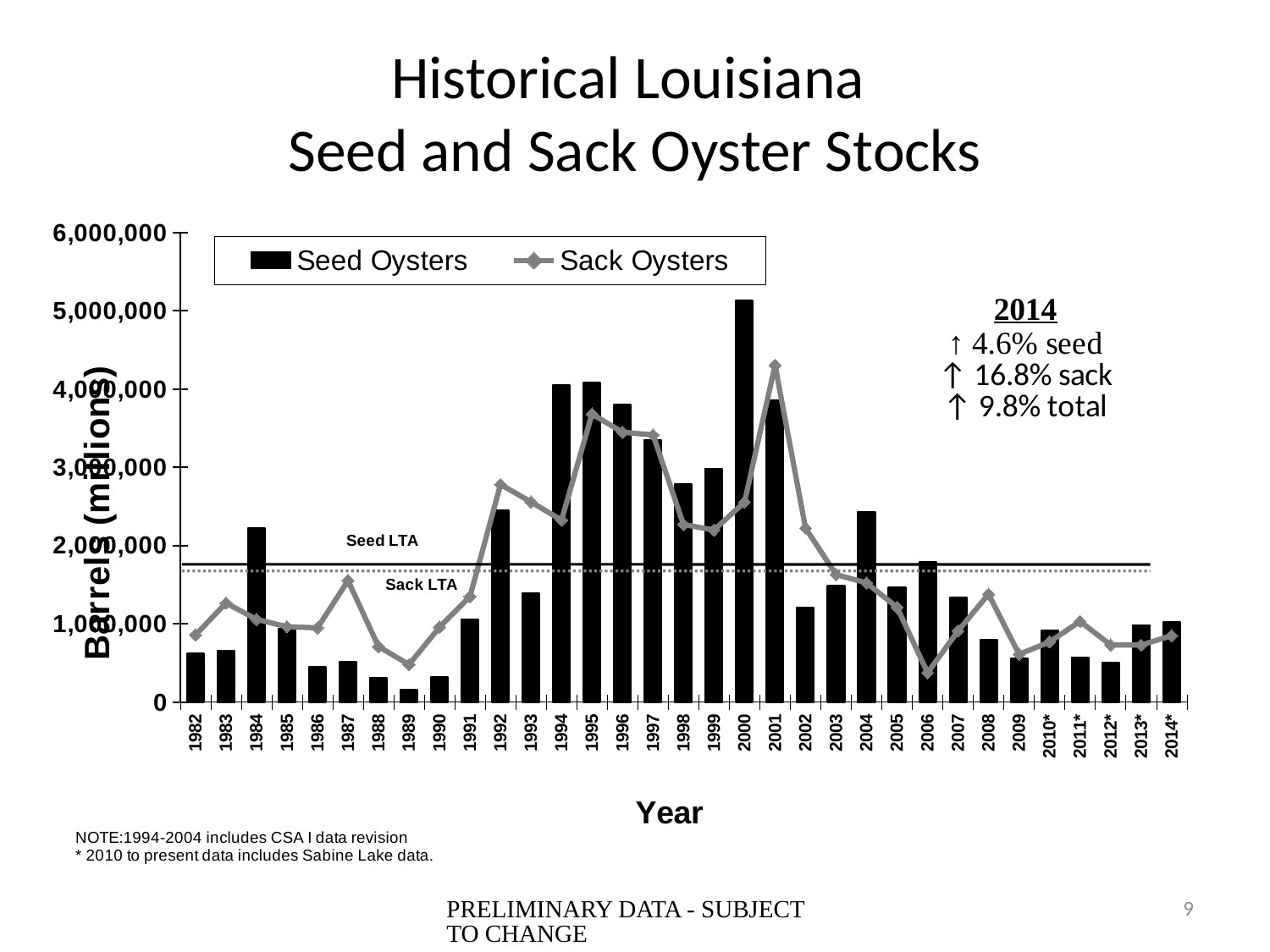
How many series does the legend list? 2 How many years are shown on the x axis? 33 Is the Sack Oysters value for 1989 greater or less than 1,000,000? less In which year does the Sack Oysters line reach its lowest point? 2006 What is the label on the x axis? Year Is the Seed Oysters value for 1984 greater or less than 2,000,000? greater In which year is the Seed Oysters bar lowest? 1989 In which year is the Seed Oysters bar highest? 2000 What are the two series named in the legend? Seed Oysters and Sack Oysters Do the Seed Oysters bars rise or fall from 2004 to 2009? fall Which is larger in 2001, the Seed Oysters bar or the Sack Oysters point? Sack Oysters In which year does the Sack Oysters line reach its highest point? 2001